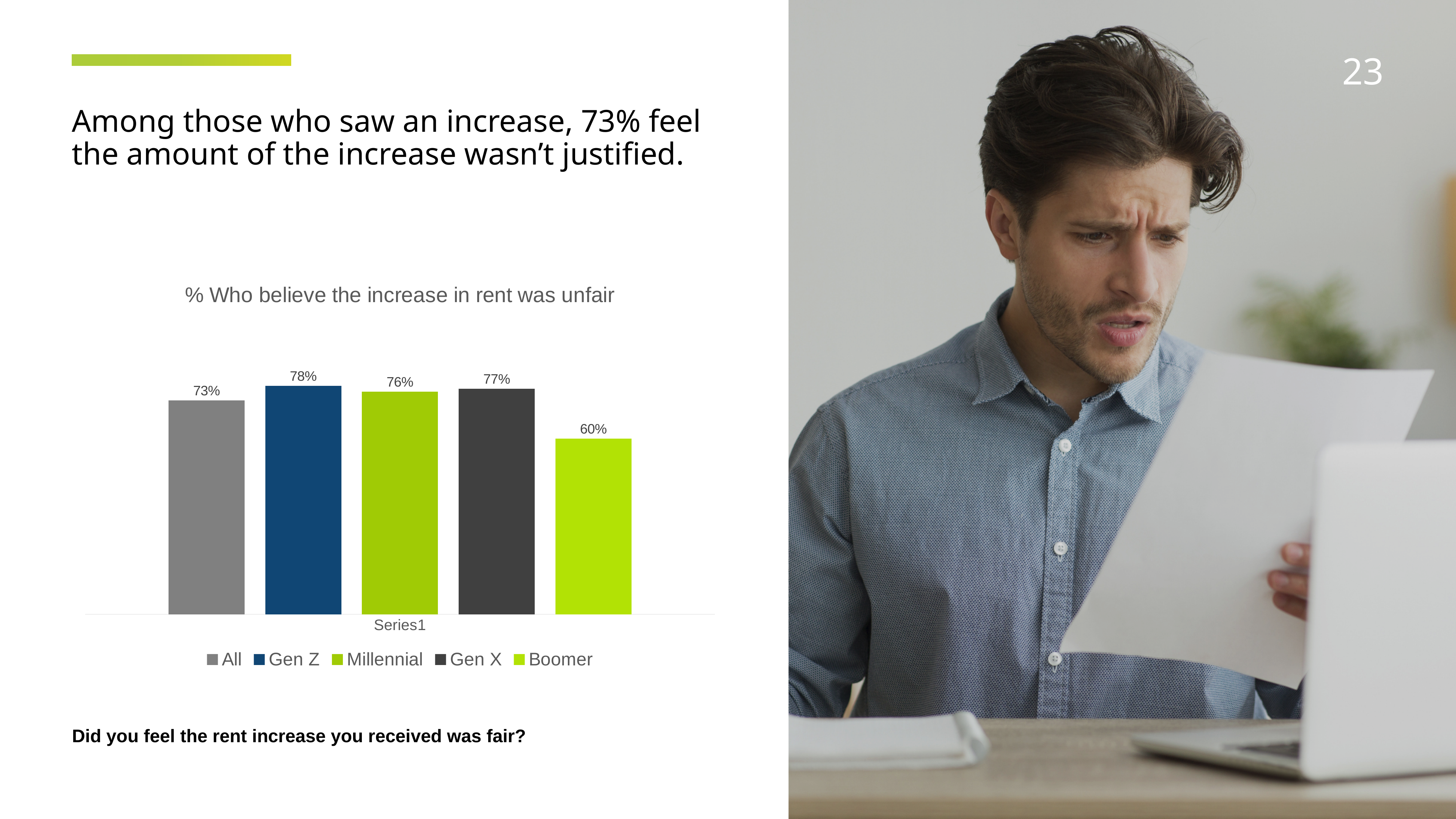
Which group has the highest value in the chart? Gen Z What kind of chart is shown on the slide? Bar chart What is the difference between the Gen Z value and the Boomer value? 18% What is the title of the chart? % Who believe the increase in rent was unfair What is the value for All in the chart? 73% What is the value for Boomer in the chart? 60% How many series does the legend list? 5 What is the value for Millennial in the chart? 76% Which group has the lowest value in the chart? Boomer What is the value for Gen Z in the chart? 78% What is the difference between the Gen X value and the All value? 4% Which is larger, the value for Millennial or the value for Boomer? Millennial